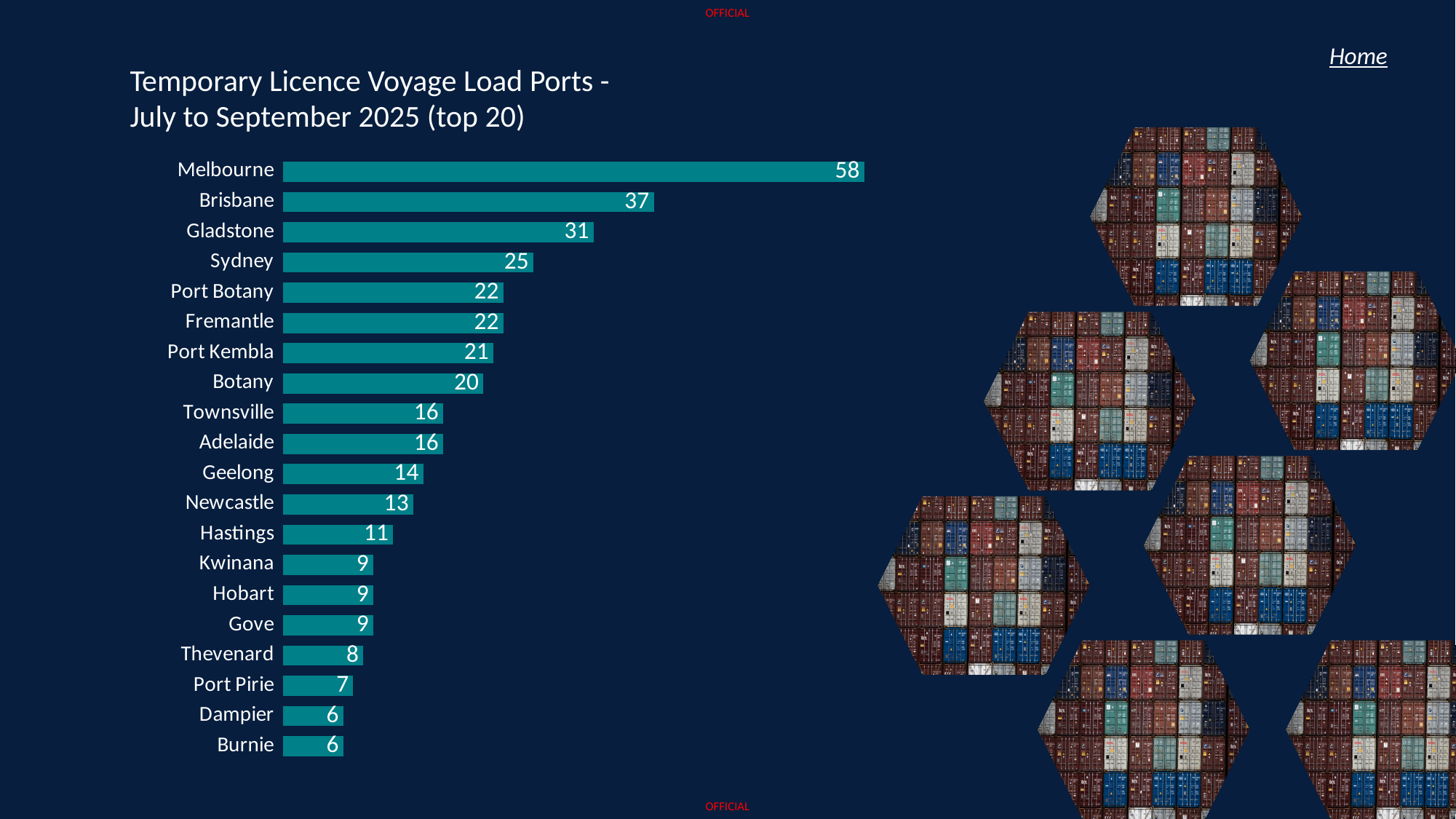
Which port has the highest value? Melbourne How many ports are shown in the chart? 20 What is the difference between the values for Sydney and Newcastle? 12 What is the title of the chart? Temporary Licence Voyage Load Ports - July to September 2025 (top 20) What is the value for Port Kembla? 21 What is the value for Melbourne? 58 Which is larger, the value for Townsville or the value for Geelong? Townsville What is the value for Hastings? 11 Which is larger, the value for Thevenard or the value for Botany? Botany What kind of chart is shown on the slide? Bar chart What is the value for Gladstone? 31 What is the difference between the values for Melbourne and Brisbane? 21